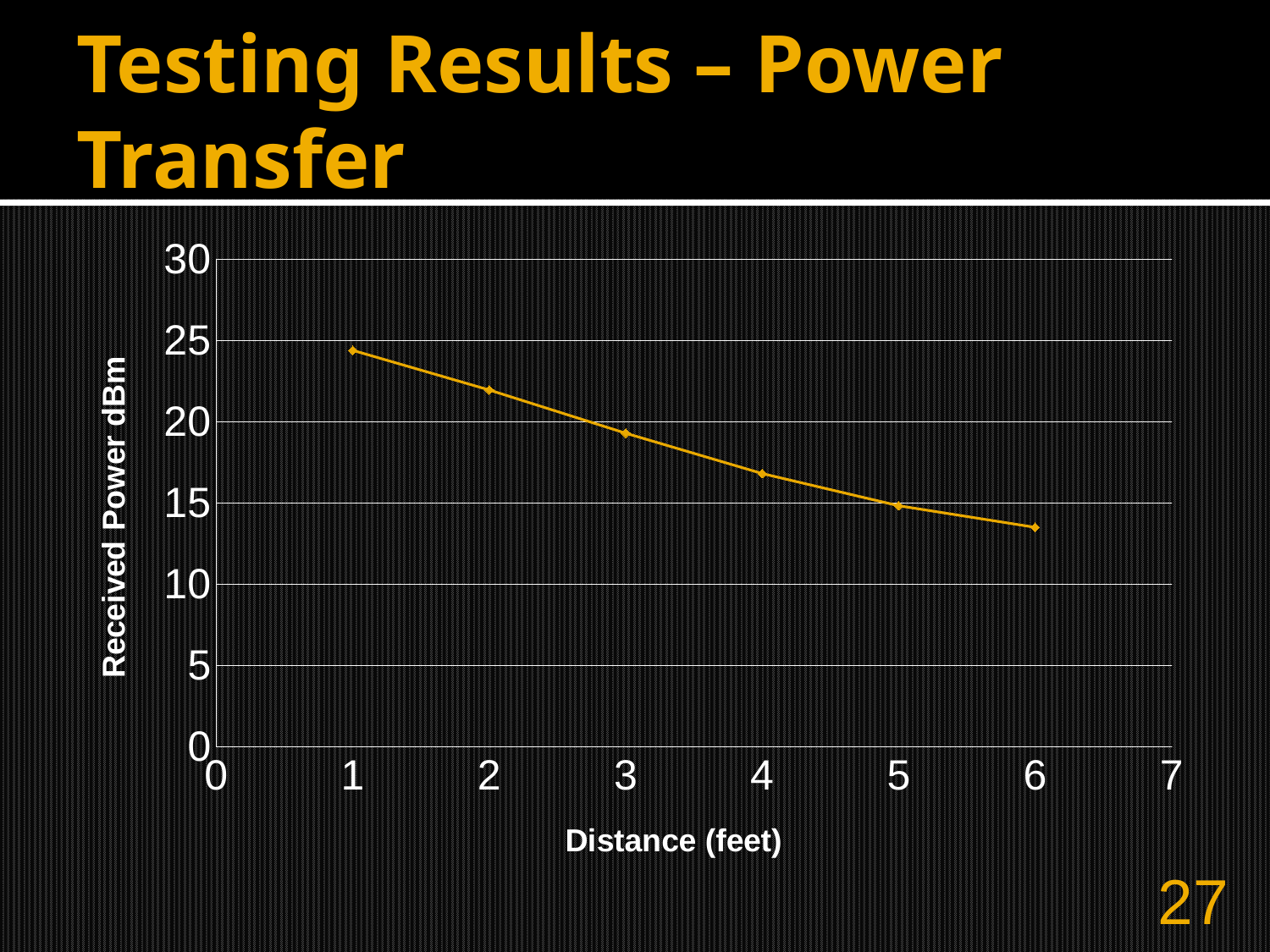
Is the received power at 4 feet greater or less than 15 dBm? greater At which distance is the received power highest? 1 foot Does the received power rise or fall as distance increases? fall What is the label of the vertical axis? Received Power dBm What kind of chart is shown on the slide? line chart At which distance is the received power lowest? 6 feet Is the received power at 6 feet greater or less than 15 dBm? less Which has the larger received power: 2 feet or 5 feet? 2 feet Is the received power at 1 foot greater or less than 20 dBm? greater What is the label of the horizontal axis? Distance (feet) How many data points are plotted on the line? 6